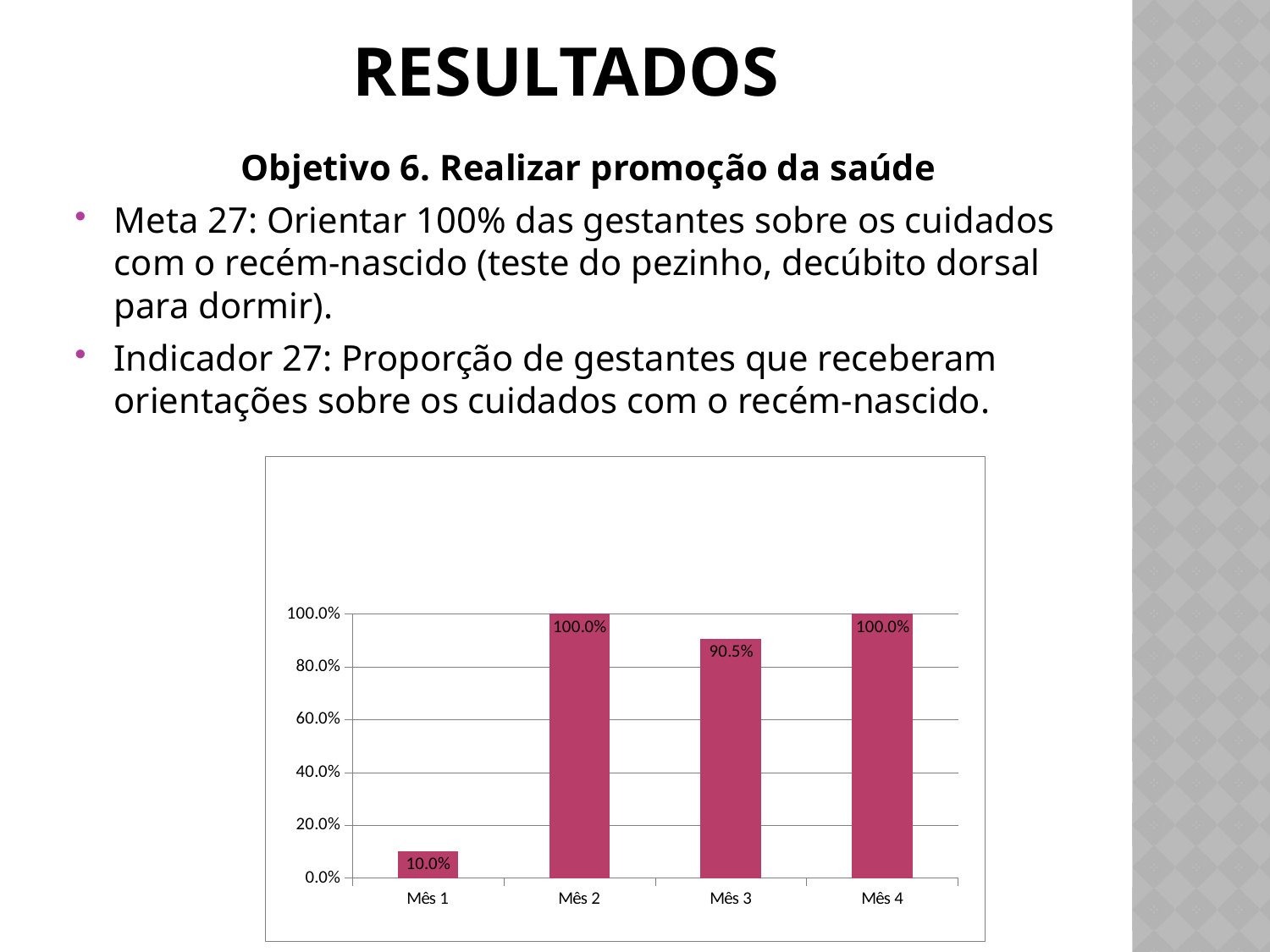
Which is larger, the value for Mês 3 or the value for Mês 4? Mês 4 Which months reach 100.0%? Mês 2 and Mês 4 How many months are shown on the x axis of the chart? 4 What is the value for Mês 3? 90.5% What is the difference between the values for Mês 3 and Mês 1? 80.5% Which month has the lowest value? Mês 1 What is the value for Mês 1? 10.0% Is the value for Mês 1 greater or less than 20.0%? less What is the difference between the values for Mês 2 and Mês 3? 9.5% What kind of chart is shown on the slide? bar chart Is the value for Mês 3 greater or less than 80.0%? greater What is the value for Mês 2? 100.0%